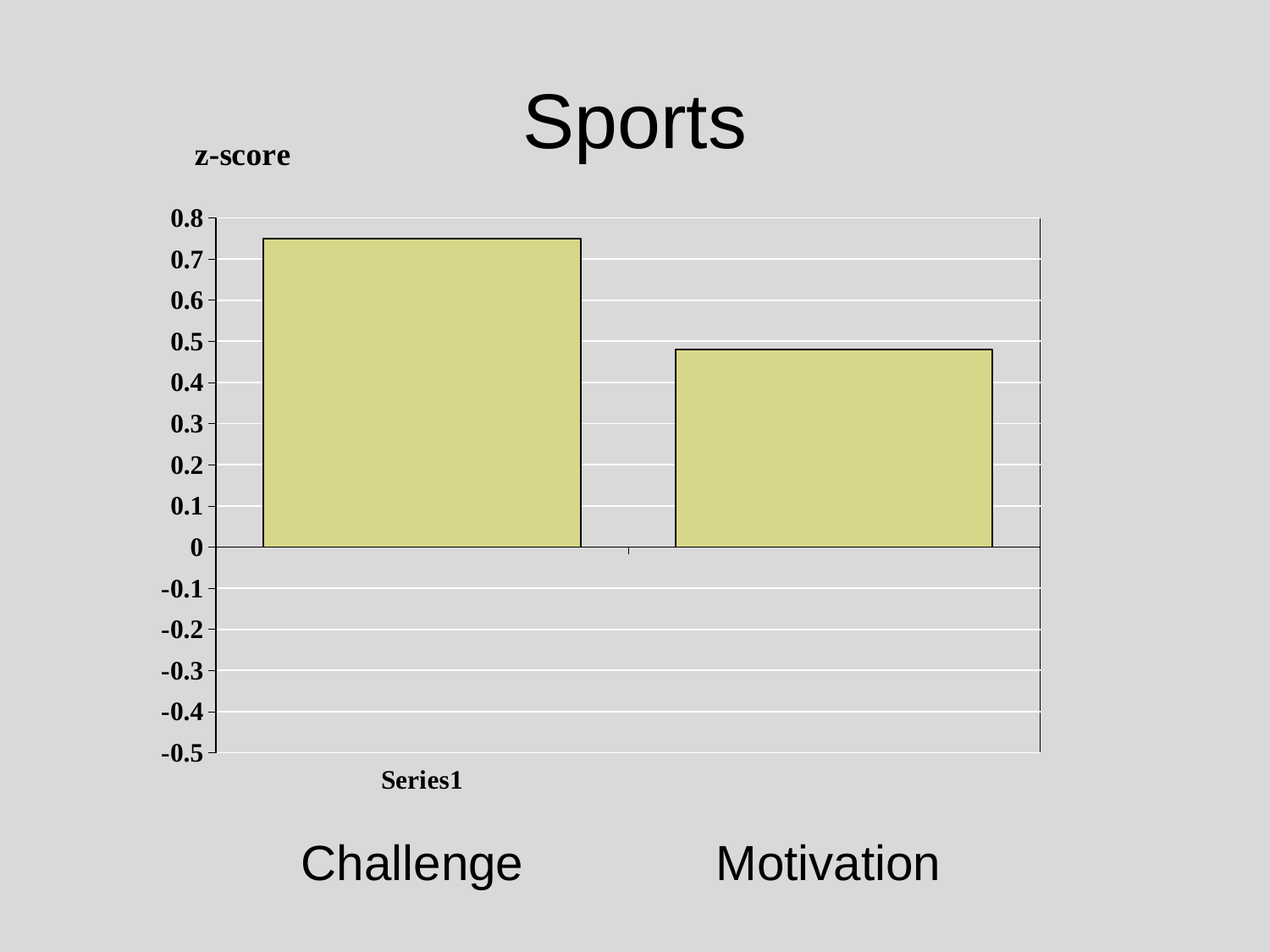
What kind of chart is shown on the slide? bar chart Is the value for Challenge greater or less than 0.8? less Which has the larger z-score, Challenge or Motivation? Challenge Is the value for Motivation greater or less than 0.4? greater How many bars are plotted in the chart? 2 Is the value for Challenge greater or less than 0.7? greater What is the title of the chart? Sports What label is shown on the vertical axis of the chart? z-score Which category has the lowest z-score? Motivation Which category has the highest z-score? Challenge